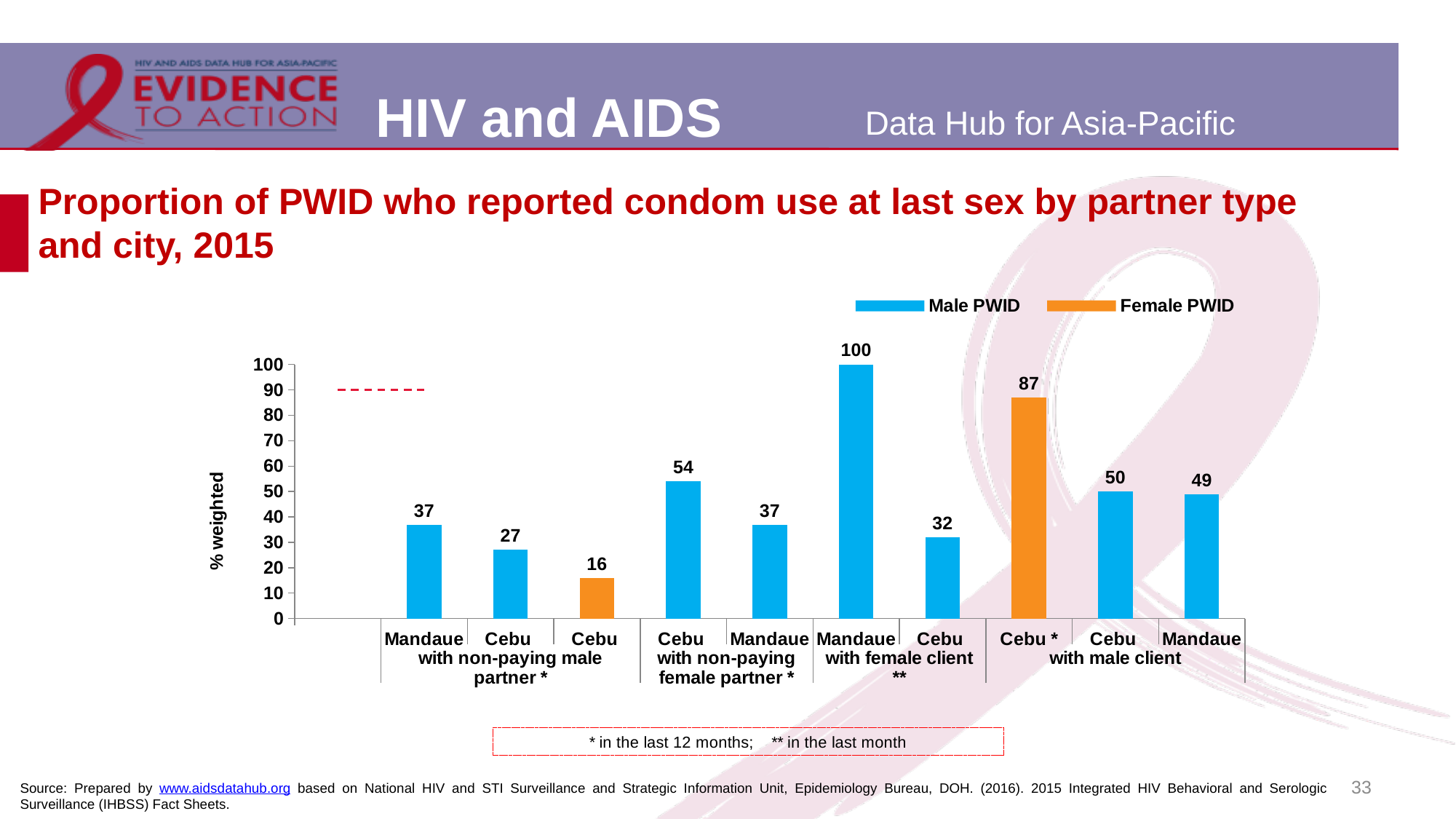
How many bars are plotted in the chart? 10 Which bar has the highest value in the chart? Mandaue with female client (100) What is the value for Cebu male PWID with a non-paying female partner? 54 In the 'with male client' group, which is larger: Cebu male PWID or Mandaue male PWID? Cebu male PWID (50) What is the label of the y-axis? % weighted What is the value for Cebu female PWID with a non-paying male partner? 16 What is the difference between the Mandaue and Cebu male PWID values in the 'with female client' group? 68 What is the value for Cebu female PWID with a male client (Cebu *)? 87 Which bar has the lowest value in the chart? Cebu female PWID with non-paying male partner (16) How many series does the legend list? 2 What is the value for Mandaue male PWID with a non-paying male partner? 37 What kind of chart is shown on the slide? Bar chart